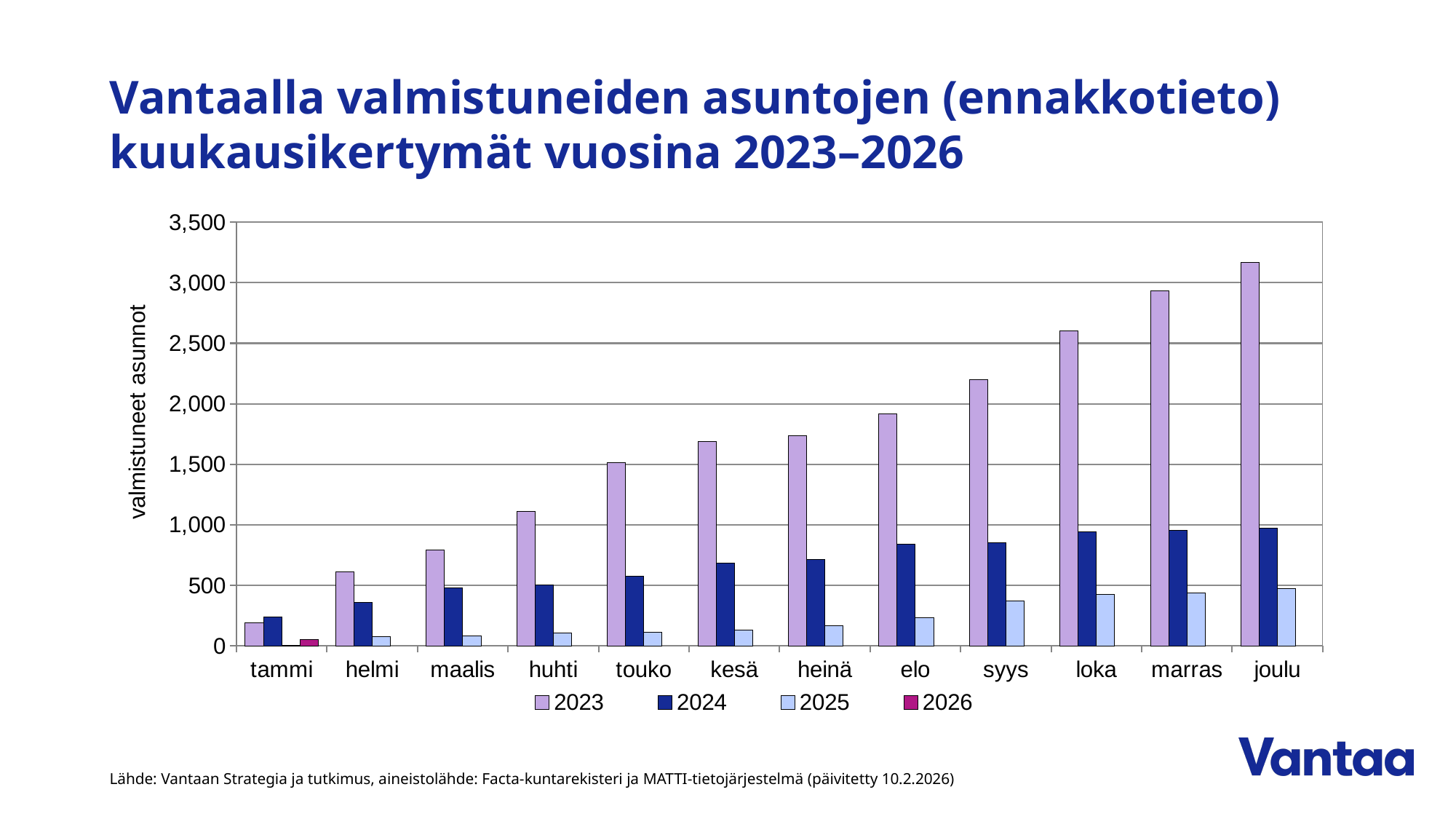
In kesä, which series has the larger value, 2023 or 2024? 2023 Is the value for 2024 in elo greater or less than 1,000? less Is the value for 2023 in loka greater or less than 2,500? greater Which month has the lowest value for the 2023 series? tammi Is the value for 2025 in syys greater or less than 500? less Do the values for the 2023 series rise or fall from tammi to joulu? rise Which month has the highest value for the 2023 series? joulu How many series does the legend list? 4 How many months (categories) are shown on the x axis? 12 What kind of chart is shown on the slide? bar chart What is the label of the vertical axis? valmistuneet asunnot